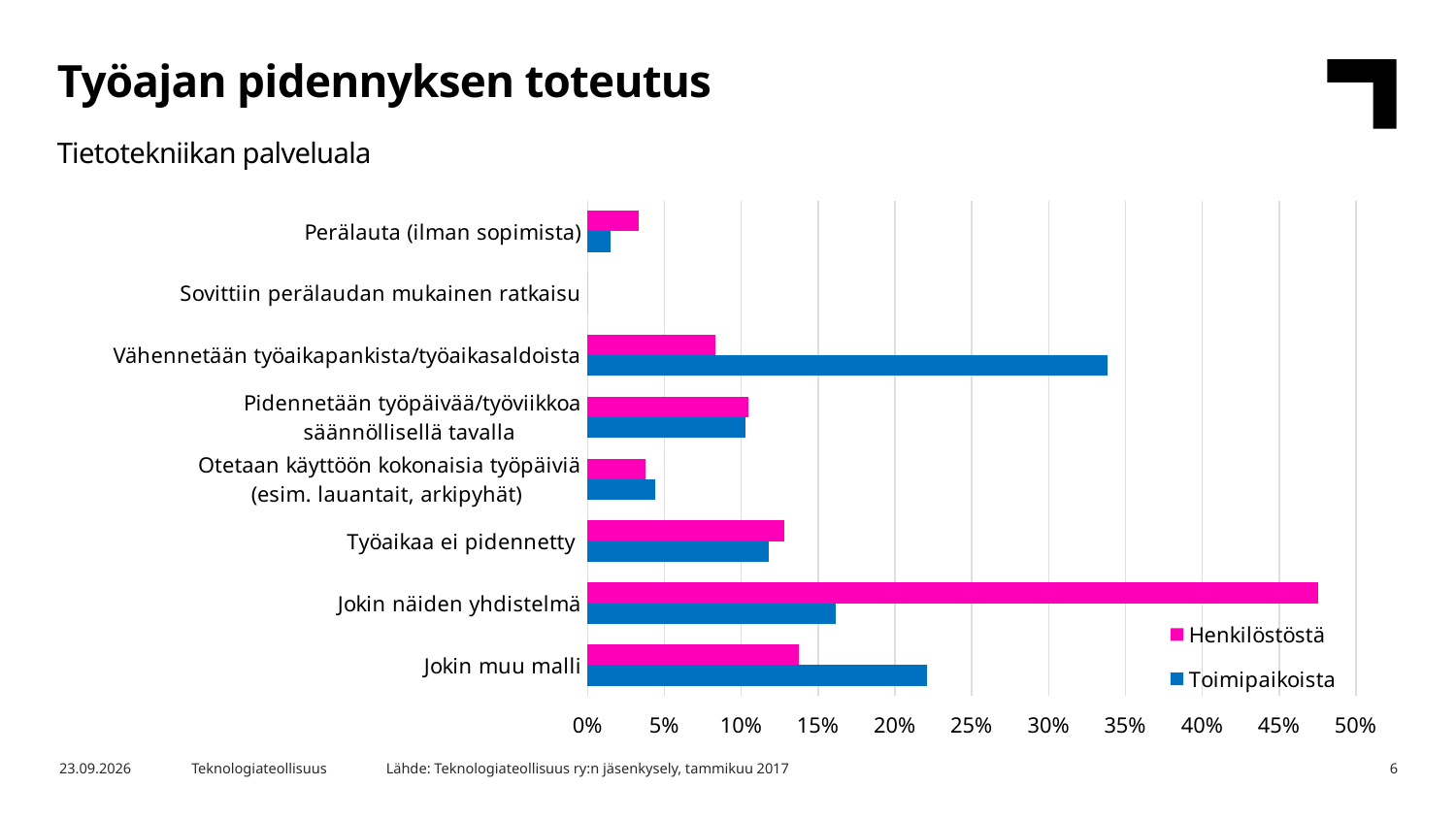
What kind of chart is shown on the slide? bar chart Is the Toimipaikoista value for Jokin muu malli greater or less than 20%? greater For Jokin muu malli, which series has the larger value, Henkilöstöstä or Toimipaikoista? Toimipaikoista Which colour represents the Henkilöstöstä series in the legend? pink How many series does the legend list? 2 Which category has the highest value for the Henkilöstöstä series? Jokin näiden yhdistelmä For Jokin näiden yhdistelmä, which series has the larger value, Henkilöstöstä or Toimipaikoista? Henkilöstöstä Is the Henkilöstöstä value for Jokin näiden yhdistelmä greater or less than 45%? greater Is the Toimipaikoista value for Perälauta (ilman sopimista) greater or less than 5%? less How many categories are shown on the vertical axis of the chart? 8 Which category has the highest value for the Toimipaikoista series? Vähennetään työaikapankista/työaikasaldoista